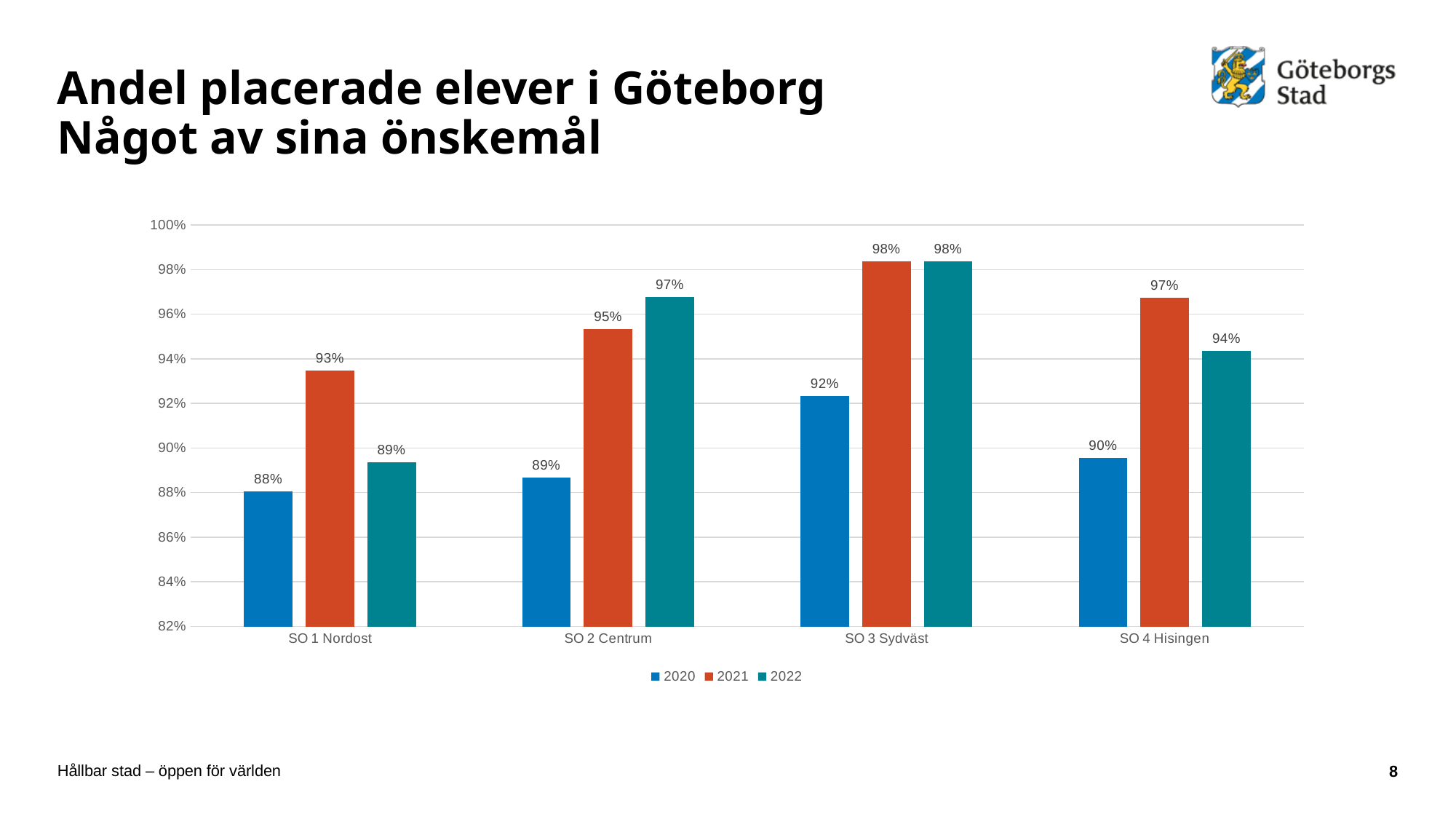
What is the difference between the 2021 and 2020 values for SO 2 Centrum? 6 percentage points Which series is shown in orange in the legend? 2021 What is the value for SO 1 Nordost in 2022? 89% What is the value for SO 2 Centrum in 2021? 95% What kind of chart is shown on the slide? Bar chart How many series does the legend list? 3 For SO 4 Hisingen, which is larger: the 2021 value or the 2022 value? 2021 Which category has the highest value for 2020? SO 3 Sydväst What is the value for SO 4 Hisingen in 2020? 90% Is the 2020 value for SO 1 Nordost greater or less than 90%? less Which category has the lowest value for 2022? SO 1 Nordost How many categories (SO areas) are shown on the x axis? 4